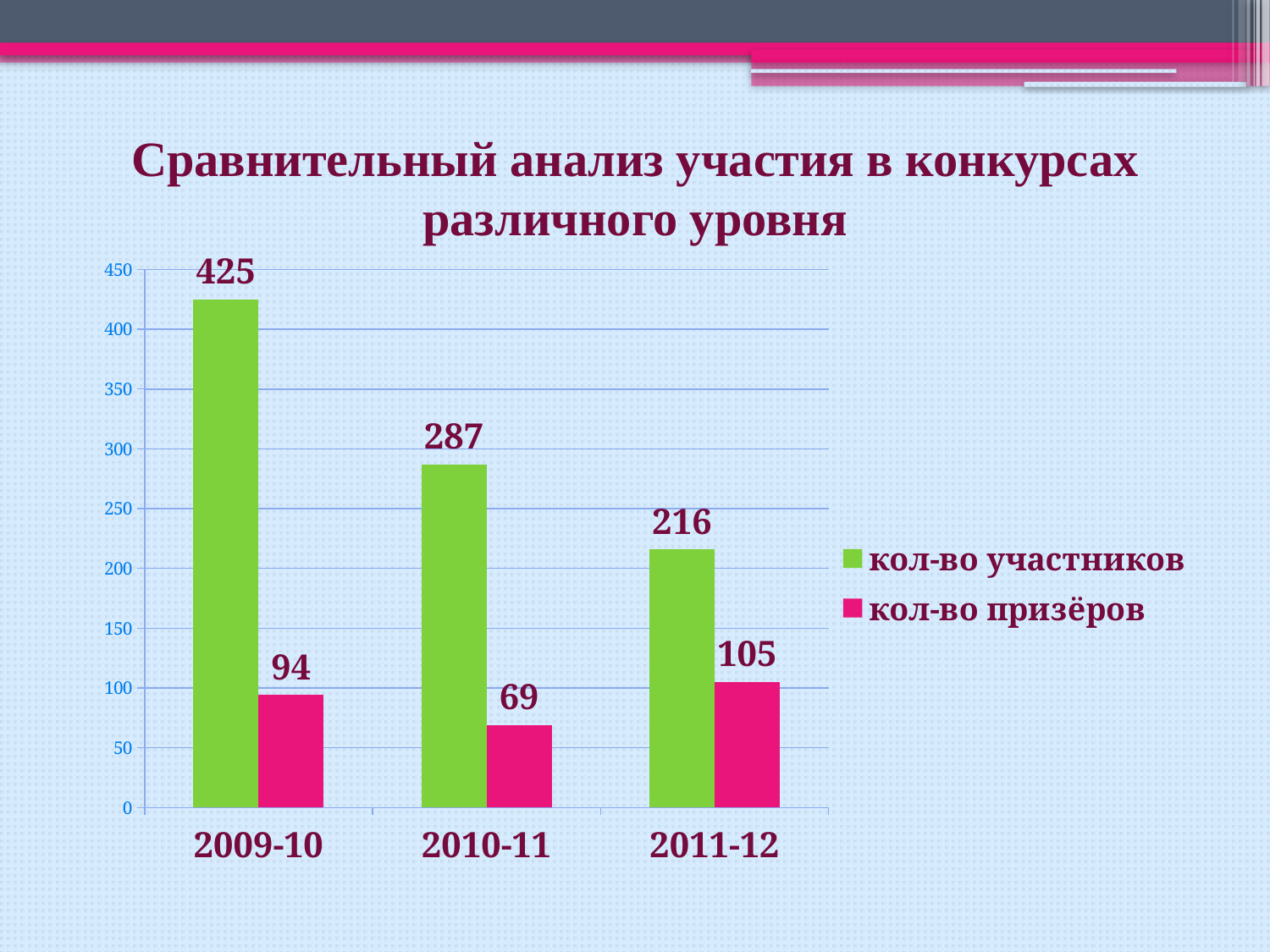
Which year has the lowest value for кол-во призёров? 2010-11 How many year categories are shown on the x axis? 3 What is the difference between кол-во участников and кол-во призёров in 2011-12? 111 What kind of chart is shown on the slide? bar chart Which is larger: кол-во призёров in 2009-10 or in 2011-12? 2011-12 Does кол-во участников rise or fall from 2009-10 to 2011-12? fall What is the value of кол-во призёров for 2010-11? 69 What is the value of кол-во призёров for 2011-12? 105 Which year has the highest value for кол-во участников? 2009-10 How many series does the legend list? 2 What is the value of кол-во участников for 2009-10? 425 What is the difference between кол-во участников in 2009-10 and 2010-11? 138